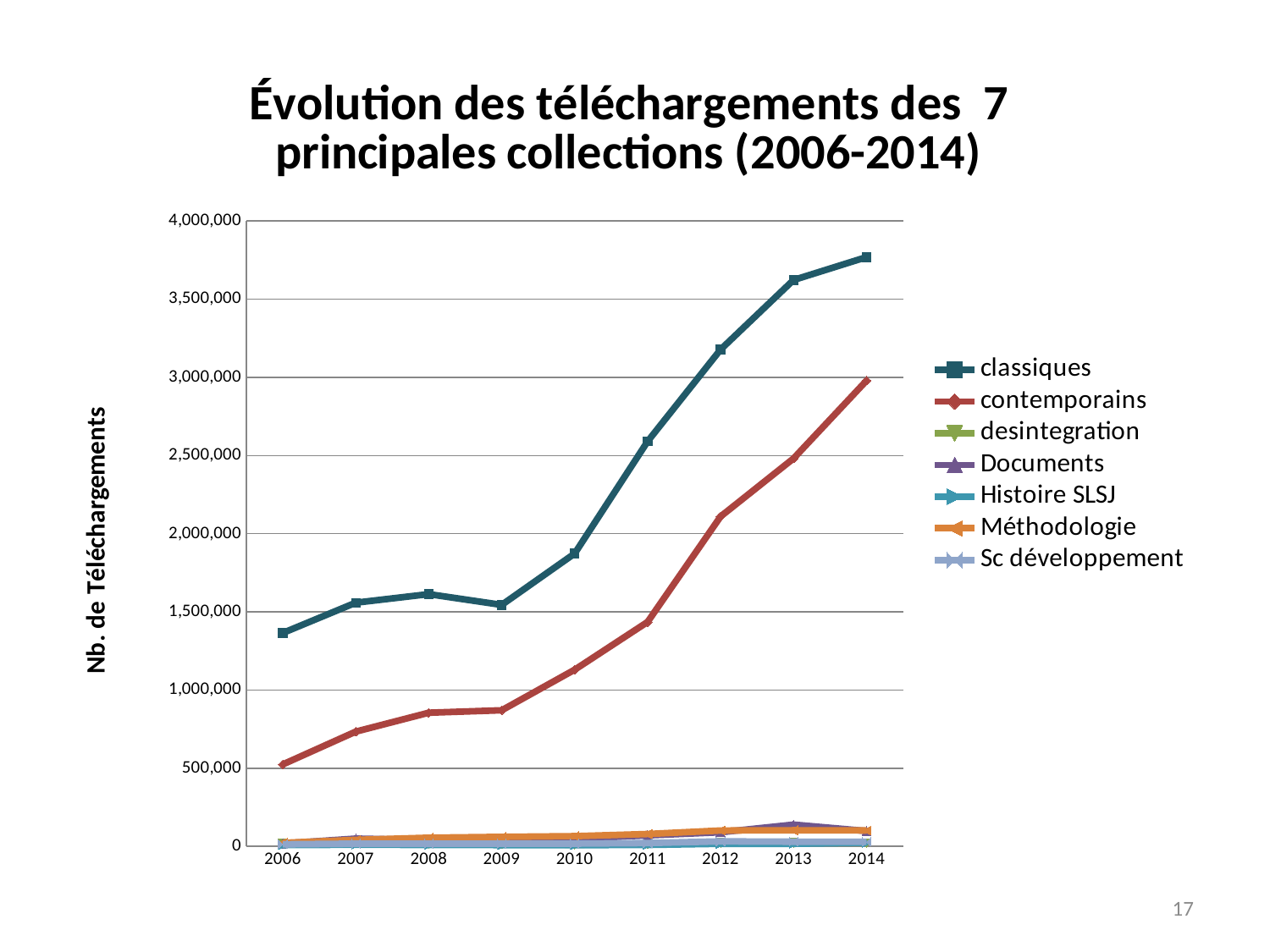
How many series does the legend list? 7 What is the title of the y axis? Nb. de Téléchargements Is the value for contemporains in 2014 greater or less than 2,500,000? greater How many years are plotted along the x axis? 9 What kind of chart is shown on the slide? line chart Do the values for classiques rise or fall overall from 2006 to 2014? rise In 2011, which series has the larger value, classiques or contemporains? classiques Is the value for classiques in 2010 greater or less than 2,000,000? less Which series has the highest value in 2014? classiques Is the value for contemporains in 2006 greater or less than 1,000,000? less